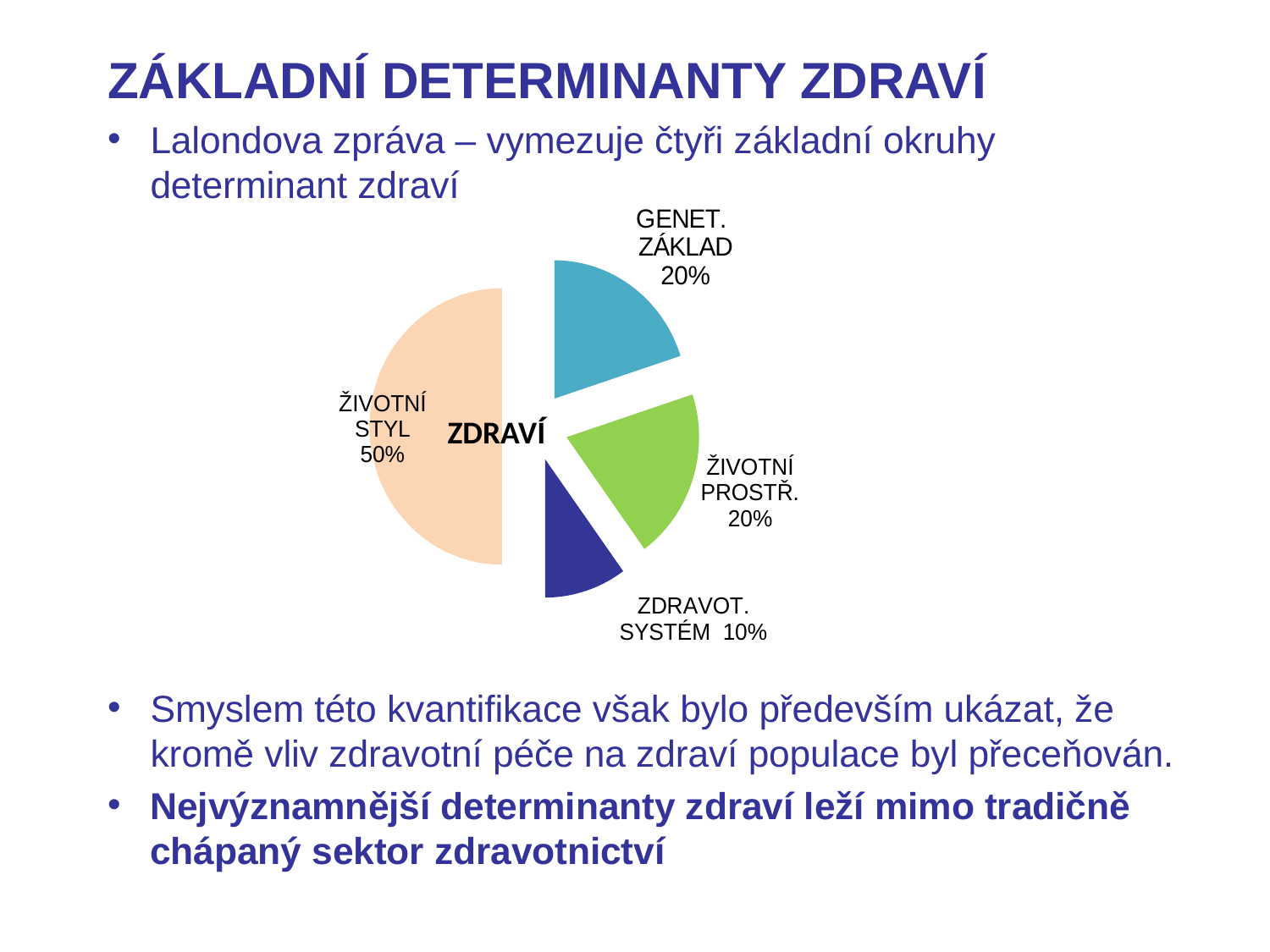
What share of the pie does ŽIVOTNÍ PROSTŘ. have? 20% Which slice of the pie is the smallest? ZDRAVOT. SYSTÉM Which slice of the pie is the largest? ŽIVOTNÍ STYL What is the difference in percentage points between ŽIVOTNÍ STYL and ZDRAVOT. SYSTÉM? 40 What share of the pie does ŽIVOTNÍ STYL have? 50% What kind of chart is shown on the slide? pie chart What is the difference in percentage points between GENET. ZÁKLAD and ZDRAVOT. SYSTÉM? 10 How many slices does the pie chart have? 4 Which is larger, the share for ŽIVOTNÍ STYL or the share for GENET. ZÁKLAD? ŽIVOTNÍ STYL What word is written in the centre of the pie chart? ZDRAVÍ What share of the pie does ZDRAVOT. SYSTÉM have? 10%